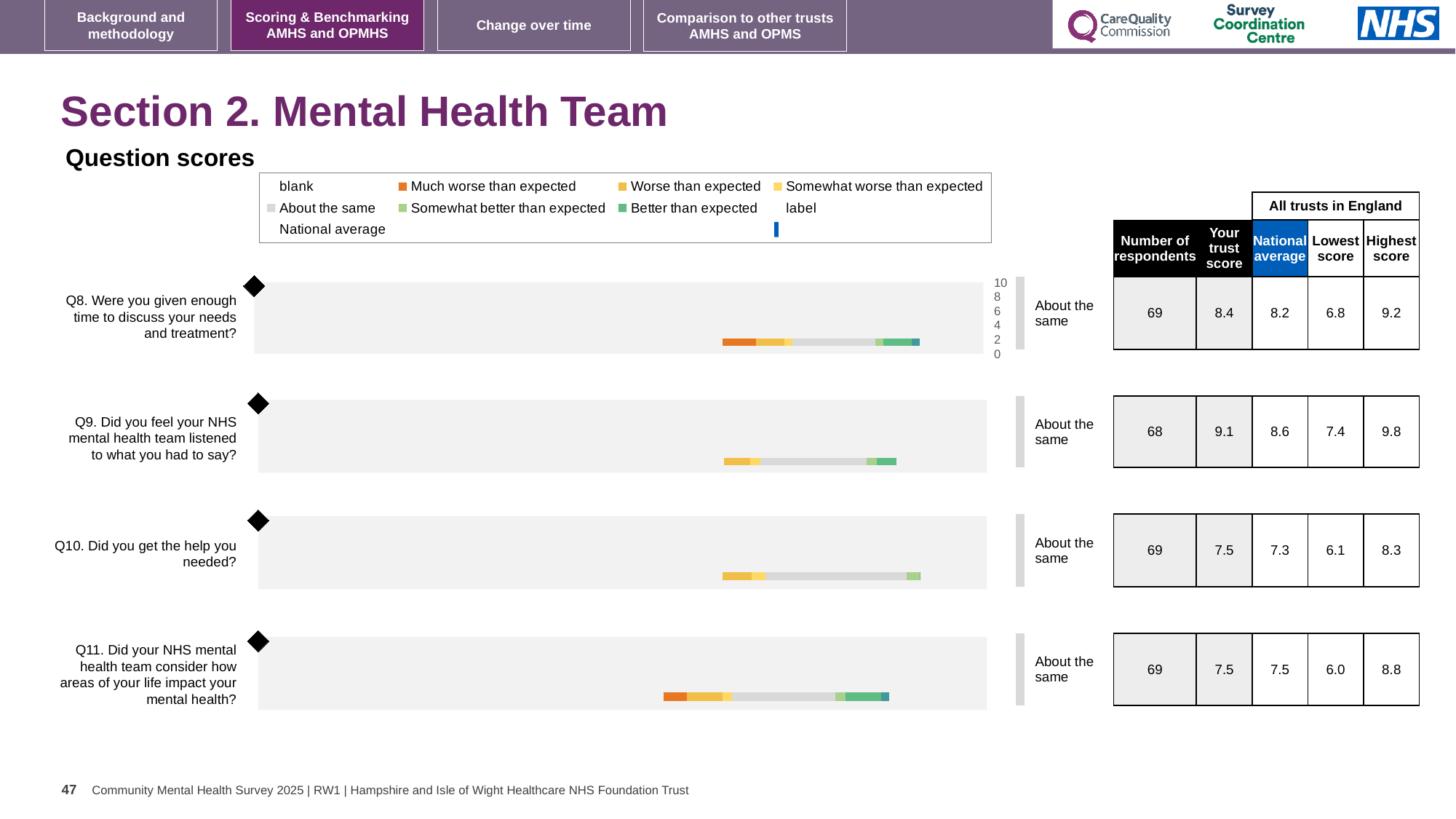
What is the highest score among all trusts in England for Q11? 8.8 How many respondents are listed for Q8 (Were you given enough time to discuss your needs and treatment?)? 69 What benchmark label is shown next to the Q10 chart? About the same What colour does the legend use for 'Much worse than expected'? Orange Which question has the lowest 'Lowest score' among all trusts in England? Q11 Which question has the highest 'Your trust score'? Q9 How many questions are charted on the slide? 4 What kind of chart is used to show the question scores for Q8 to Q11? bar chart For Q9, what is the difference between the highest score and the lowest score among all trusts in England? 2.4 For Q8, which is larger: the trust score or the national average? Your trust score (8.4) What is the national average for Q10 (Did you get the help you needed?)? 7.3 What is the 'Your trust score' value for Q9 (Did you feel your NHS mental health team listened to what you had to say?)? 9.1